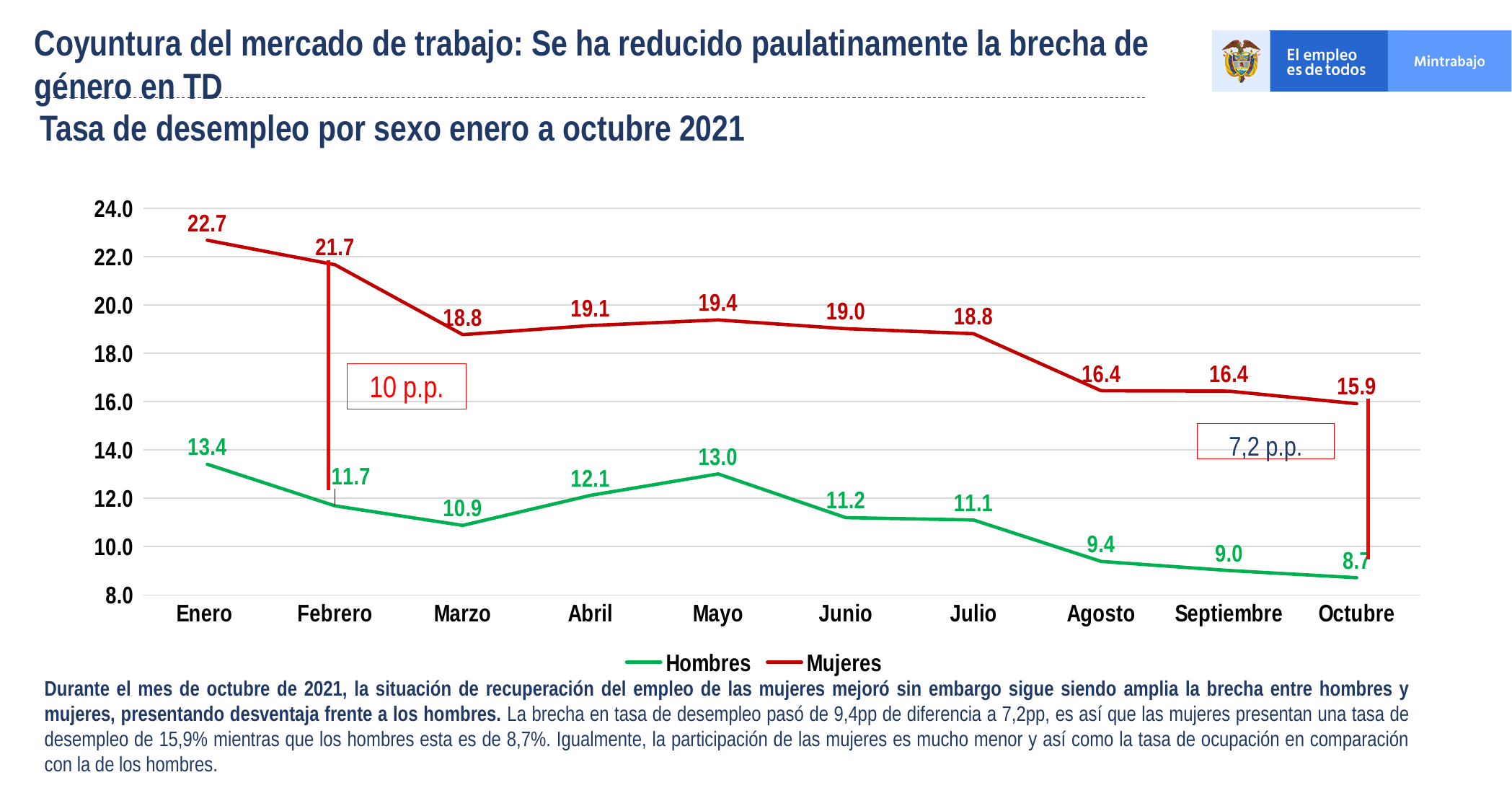
What type of chart is shown on the slide? line chart What is the unemployment rate for Mujeres in Enero? 22.7 What is the difference between the Mujeres and Hombres values in Febrero? 10.0 What is the difference between the Mujeres and Hombres values in Octubre? 7.2 Which is larger, the Hombres value in Mayo or the Hombres value in Abril? Mayo In which month is the Hombres series lowest? Octubre How many months are plotted on the x axis? 10 In which month is the Mujeres series highest? Enero How many series does the legend list? 2 Does the Mujeres series generally rise or fall from Enero to Octubre? fall What is the unemployment rate for Hombres in Octubre? 8.7 What is the value for Mujeres in Mayo? 19.4